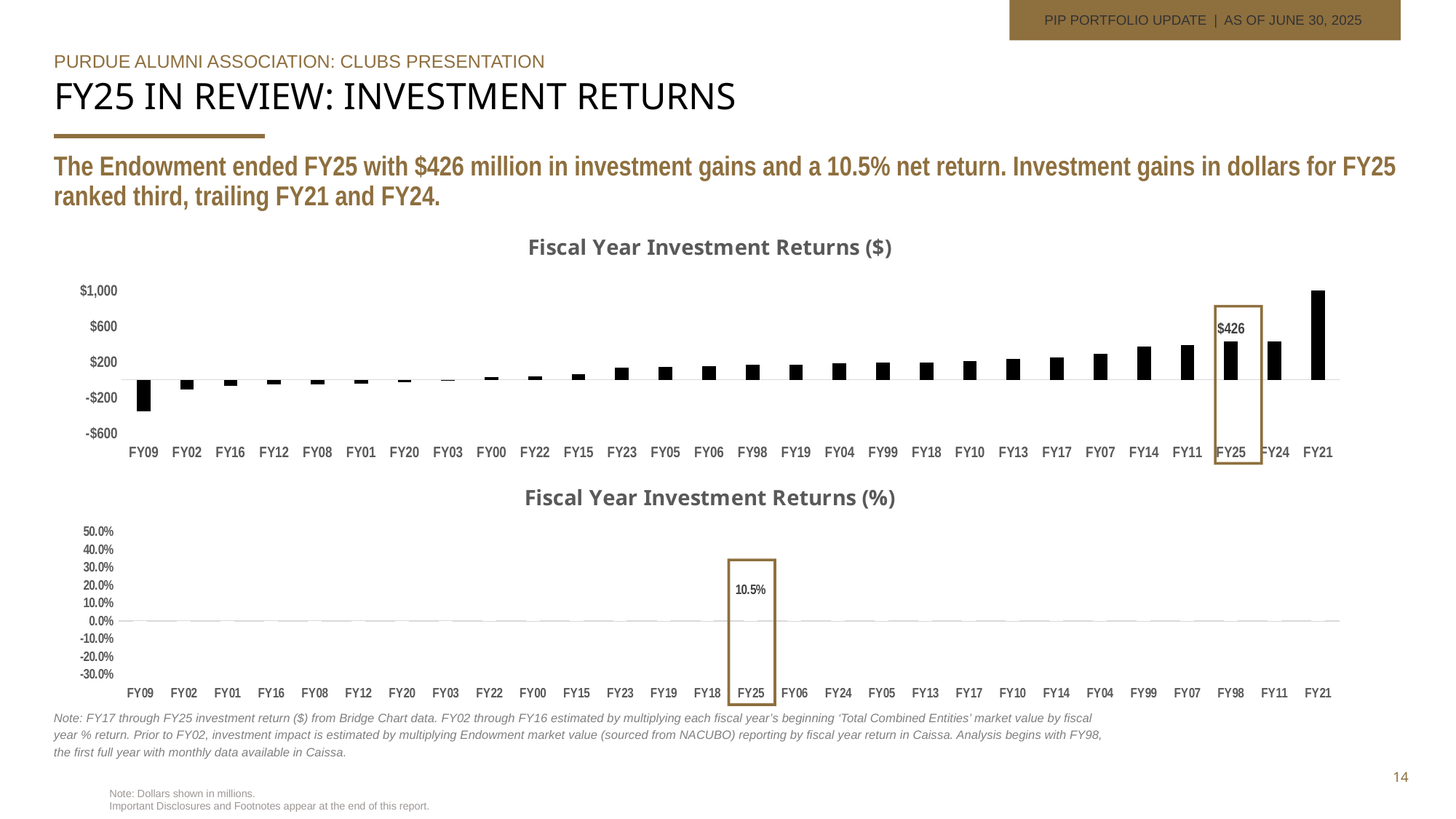
In the 'Fiscal Year Investment Returns ($)' chart, which is larger, the value for FY24 or the value for FY11? FY24 In the 'Fiscal Year Investment Returns ($)' chart, which fiscal year is highlighted with a box outline? FY25 What kind of chart is the 'Fiscal Year Investment Returns ($)' chart? Bar chart In the 'Fiscal Year Investment Returns (%)' chart, what is the value shown for FY25? 10.5% How many fiscal years are shown on the x axis of the 'Fiscal Year Investment Returns ($)' chart? 28 In the 'Fiscal Year Investment Returns ($)' chart, what is the value shown for FY25? $426 In the 'Fiscal Year Investment Returns ($)' chart, which fiscal year has the highest value? FY21 In the 'Fiscal Year Investment Returns ($)' chart, is the value for FY21 greater or less than $600? greater In the 'Fiscal Year Investment Returns ($)' chart, do the values generally rise or fall moving from left to right along the x axis? Rise In the 'Fiscal Year Investment Returns ($)' chart, which fiscal year has the lowest value? FY09 How many fiscal years are listed on the x axis of the 'Fiscal Year Investment Returns (%)' chart? 28 In the 'Fiscal Year Investment Returns ($)' chart, is the value for FY09 greater or less than -$200? less